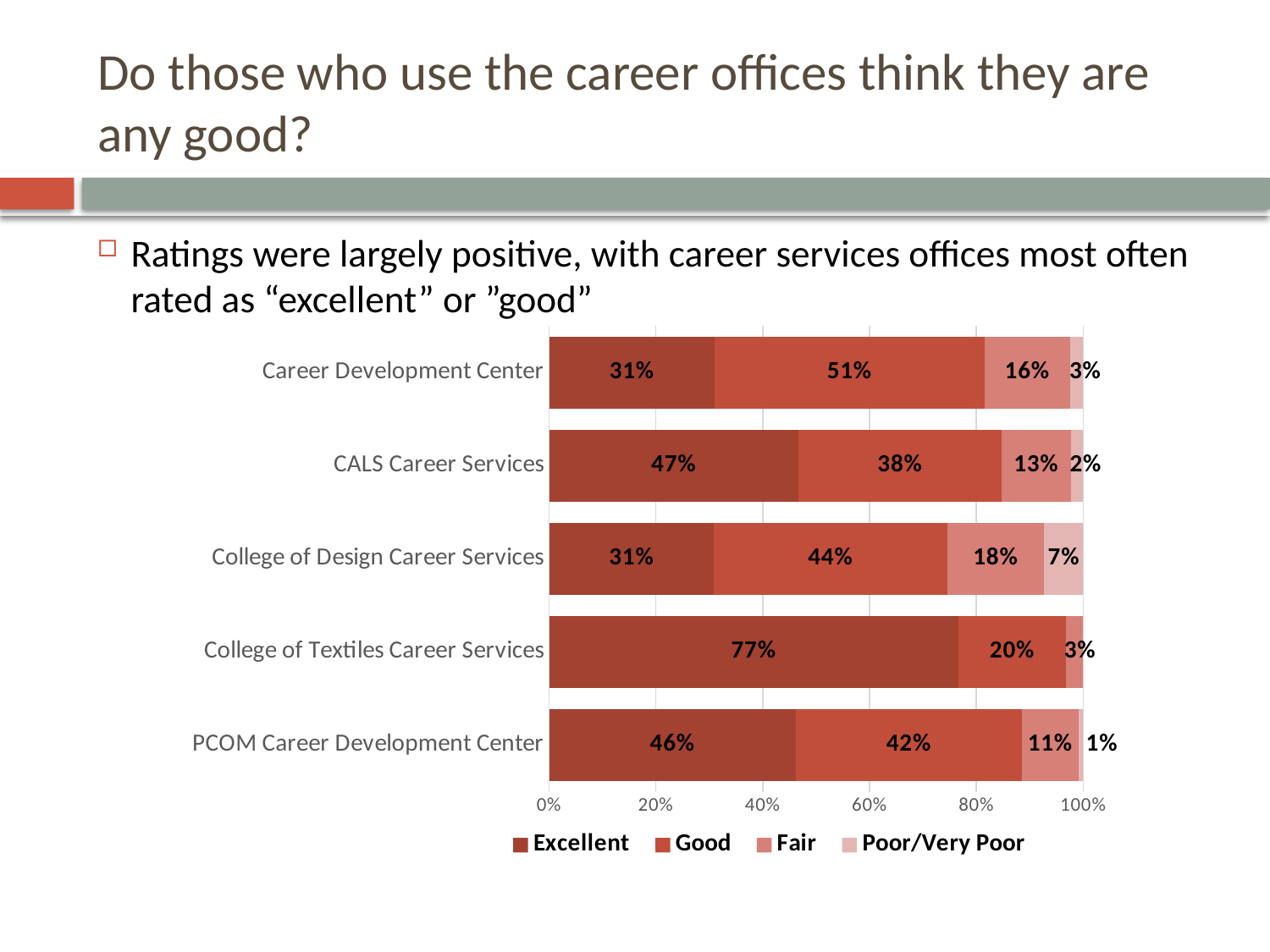
What type of chart is shown on the slide? Stacked bar chart What is the Good rating percentage for the Career Development Center? 51% Which has a larger Fair rating, College of Design Career Services or CALS Career Services? College of Design Career Services Which career office has the lowest Good rating? College of Textiles Career Services What percentage of College of Textiles Career Services users rated it Excellent? 77% What is the Fair rating percentage for PCOM Career Development Center? 11% How many career offices are shown in the chart? 5 What percentage of College of Design Career Services users gave a Poor/Very Poor rating? 7% What is the combined Excellent and Good rating for PCOM Career Development Center? 88% Which career office has the highest Excellent rating? College of Textiles Career Services How many rating categories does the legend list? 4 What is the difference between the Excellent ratings of CALS Career Services and the Career Development Center? 16%